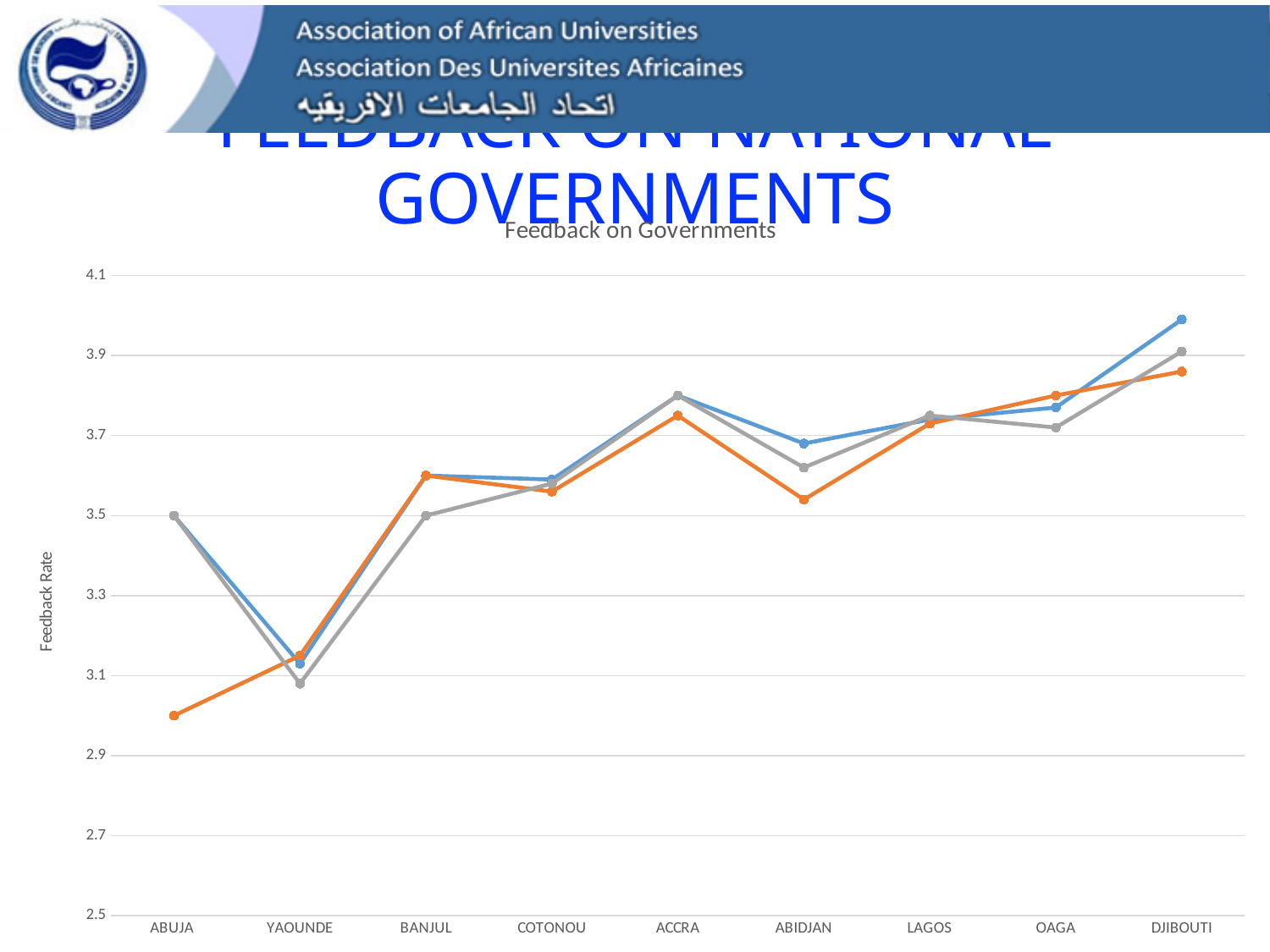
Overall, do the values on the blue line rise or fall from ABUJA to DJIBOUTI? rise How many cities are shown along the x axis of the chart? 9 Which city has the highest value on the blue line? DJIBOUTI Which city has the lowest value on the blue line? YAOUNDE Which city has the lowest value on the orange line? ABUJA Is the value of the orange line at ABUJA greater or less than 3.1? less What kind of chart is shown on the slide? line chart Is the value of the blue line at DJIBOUTI greater or less than 3.9? greater At ABIDJAN, which line has the larger value, the blue line or the orange line? blue line What is the title of the chart? Feedback on Governments What is the label on the vertical axis of the chart? Feedback Rate Is the value of the gray line at ACCRA greater or less than 3.7? greater